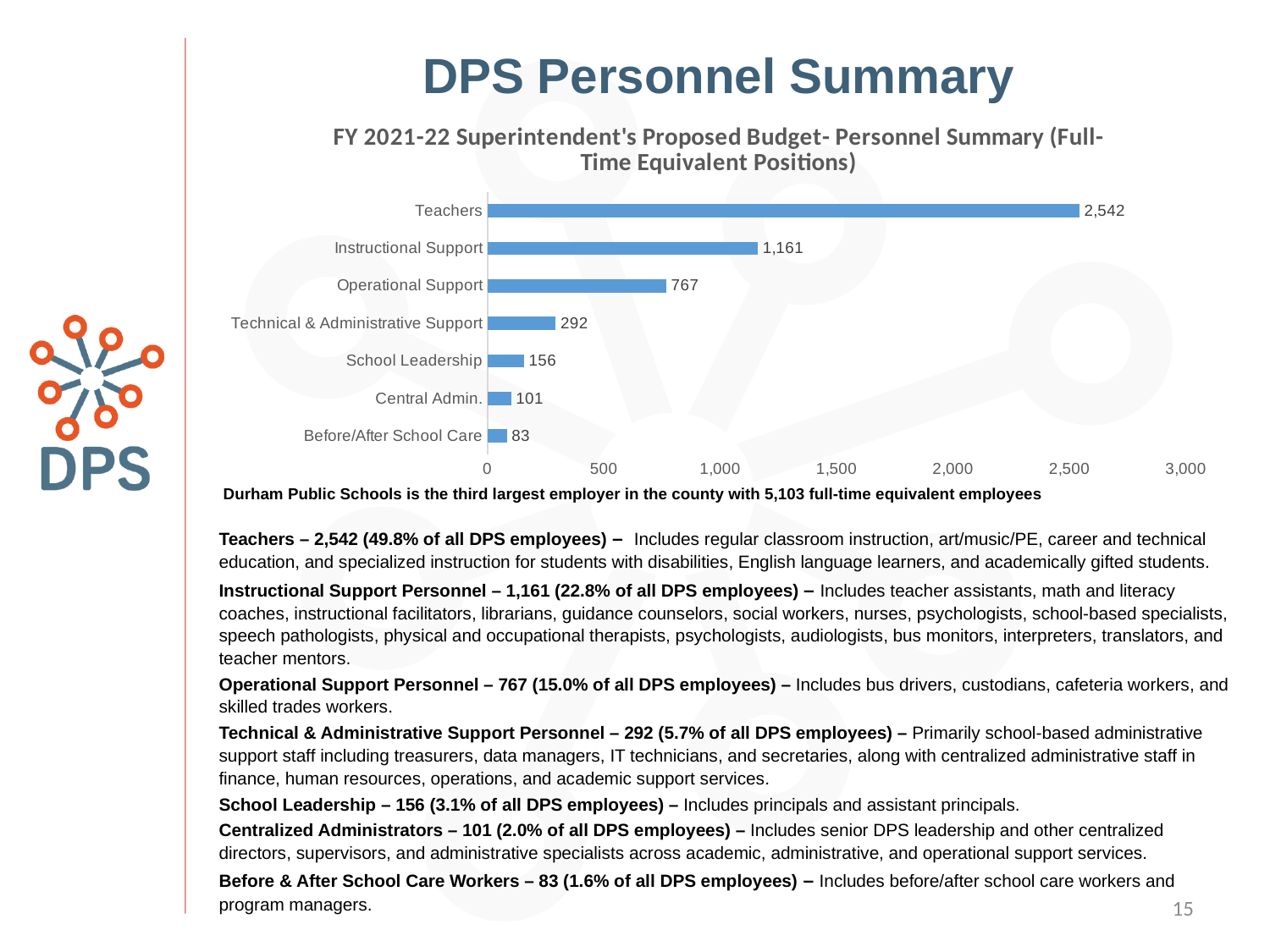
Which category has the highest value? Teachers How many categories are shown in the chart? 7 What is the difference between the values for Teachers and Instructional Support? 1,381 What is the value for Operational Support? 767 Which category has the lowest value? Before/After School Care What is the difference between the values for School Leadership and Central Admin.? 55 Which is larger, the value for Technical & Administrative Support or the value for School Leadership? Technical & Administrative Support What is the value for Central Admin.? 101 What is the value for Teachers? 2,542 Is the value for Instructional Support greater or less than 1,000? greater What kind of chart is shown on the slide? bar chart What is the title of the chart? FY 2021-22 Superintendent's Proposed Budget- Personnel Summary (Full-Time Equivalent Positions)